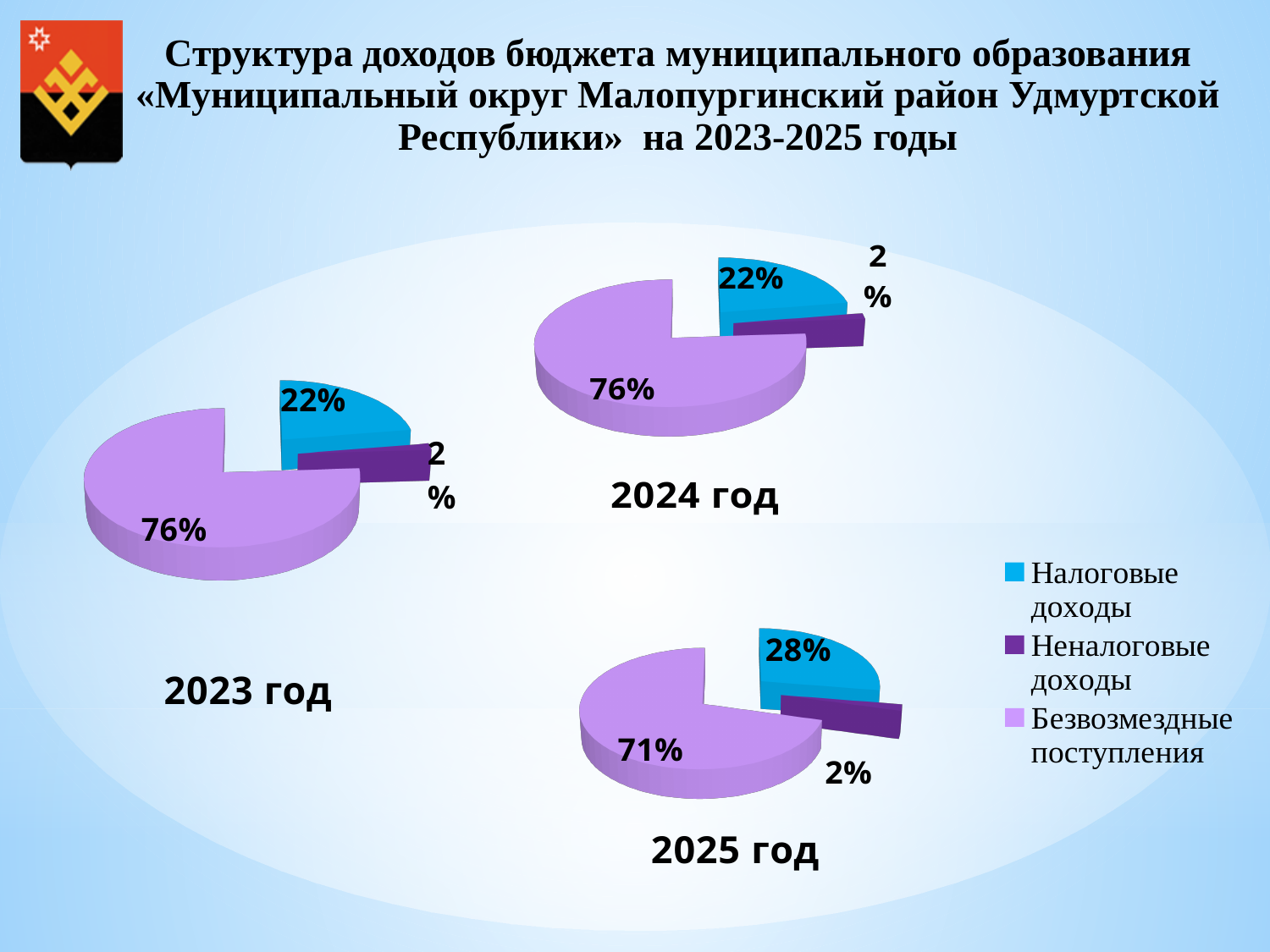
In the 2023 год pie chart, what share is Налоговые доходы? 22% What type of chart is used for the 2023 год data? Pie chart How many pie charts are on the slide? 3 In the 2023 год pie chart, what share is Безвозмездные поступления? 76% Which is larger: the share of Налоговые доходы in the 2025 год chart or in the 2024 год chart? 2025 год How many categories does each pie chart show? 3 In the 2025 год pie chart, which category has the largest share? Безвозмездные поступления In the 2025 год pie chart, what share is Налоговые доходы? 28% In the 2024 год pie chart, what share is Неналоговые доходы? 2% In the 2024 год pie chart, which category has the smallest share? Неналоговые доходы In the 2025 год pie chart, what share is Безвозмездные поступления? 71% In the 2025 год pie chart, what is the difference between the shares of Безвозмездные поступления and Налоговые доходы? 43%